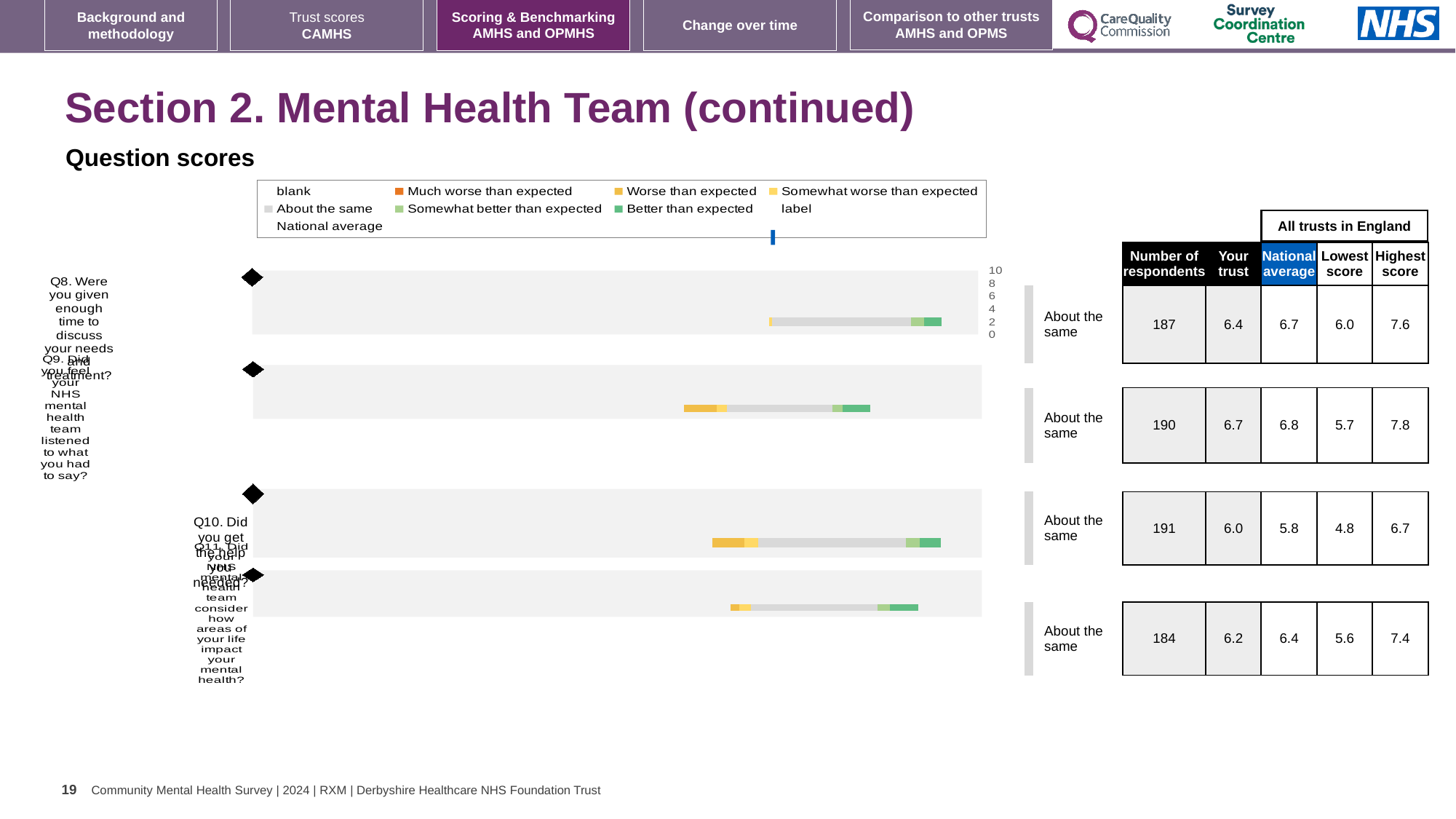
What is the difference between the highest score and the lowest score for Q8 in the table? 1.6 What benchmark category is shown for all four questions on this slide? About the same In the chart legend, which colour represents 'Better than expected'? green For Q10, is the 'Your trust' score or the national average higher? Your trust How many respondents answered Q10 according to the table beside the chart? 191 What is the national average score for Q9 in the table beside the chart? 6.8 How many questions (categories) are plotted in the question scores chart? 4 Which question has the highest 'Your trust' score in the table beside the chart? Q9 What is the highest score across all trusts in England for Q11? 7.4 What is the 'Your trust' score for Q8 in the table beside the chart? 6.4 In the chart legend, which colour represents 'Much worse than expected'? orange What kind of chart is used to show the question scores on this slide? bar chart